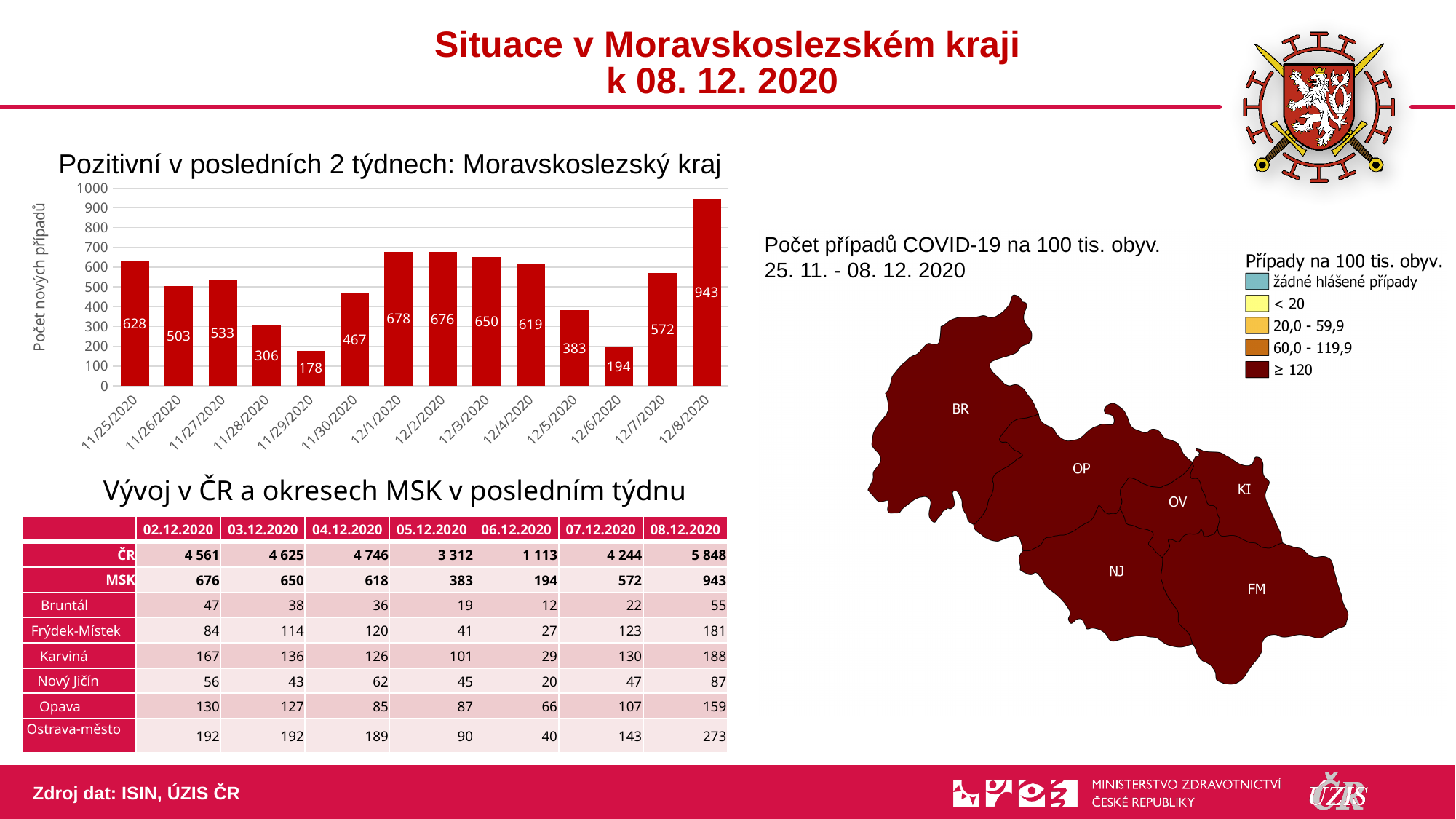
Which date has the lowest bar in the bar chart? 11/29/2020 In the bar chart, what is the value for 12/5/2020? 383 How many dates (bars) are shown in the bar chart? 14 In the bar chart, which is larger: the value for 11/25/2020 or 11/26/2020? 11/25/2020 In the bar chart, do the values rise or fall from 12/2/2020 to 12/6/2020? fall What type of chart is shown under the title 'Pozitivní v posledních 2 týdnech: Moravskoslezský kraj'? bar chart In the bar chart, what is the difference between the values for 12/8/2020 and 12/7/2020? 371 Which date has the highest bar in the bar chart? 12/8/2020 In the bar chart, is the value for 12/8/2020 greater or less than 900? greater In the bar chart, what is the value for 11/25/2020? 628 What is the label of the vertical axis of the bar chart? Počet nových případů In the bar chart, what is the value for 11/30/2020? 467